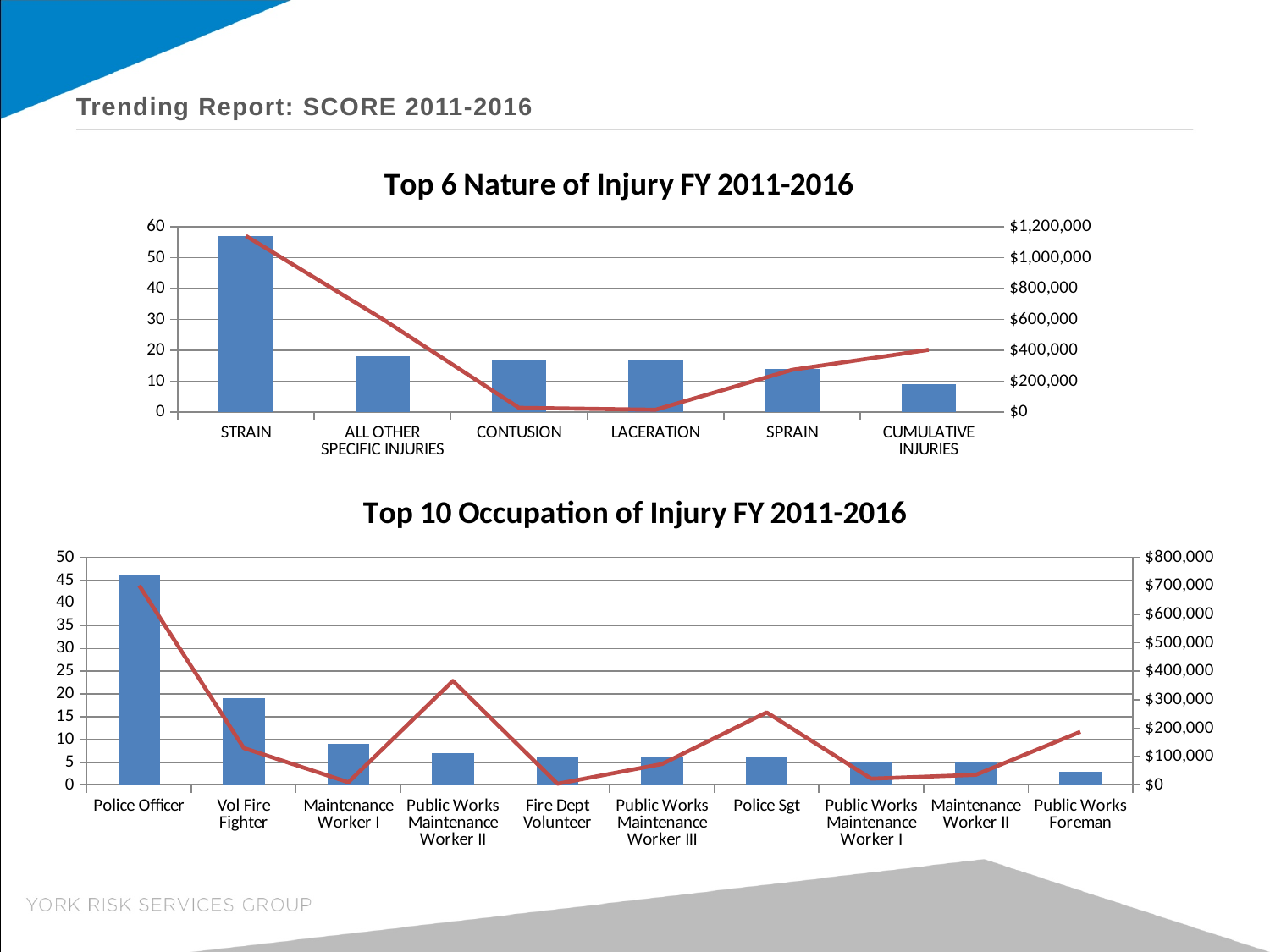
In the 'Top 10 Occupation of Injury FY 2011-2016' chart, is the line value for Public Works Maintenance Worker II greater or less than $300,000? greater In the 'Top 6 Nature of Injury FY 2011-2016' chart, how many injury categories are shown on the x axis? 6 In the 'Top 10 Occupation of Injury FY 2011-2016' chart, which occupation has the lowest bar? Public Works Foreman In the 'Top 6 Nature of Injury FY 2011-2016' chart, which category has the highest bar? STRAIN What type of chart is the 'Top 10 Occupation of Injury FY 2011-2016' chart? Combined bar and line chart In the 'Top 6 Nature of Injury FY 2011-2016' chart, is the bar for STRAIN greater or less than 50? greater In the 'Top 10 Occupation of Injury FY 2011-2016' chart, which has the larger bar, Vol Fire Fighter or Maintenance Worker I? Vol Fire Fighter In the 'Top 6 Nature of Injury FY 2011-2016' chart, which category has the lowest bar? CUMULATIVE INJURIES In the 'Top 10 Occupation of Injury FY 2011-2016' chart, which occupation has the highest bar? Police Officer In the 'Top 6 Nature of Injury FY 2011-2016' chart, is the line value for LACERATION greater or less than $200,000? less